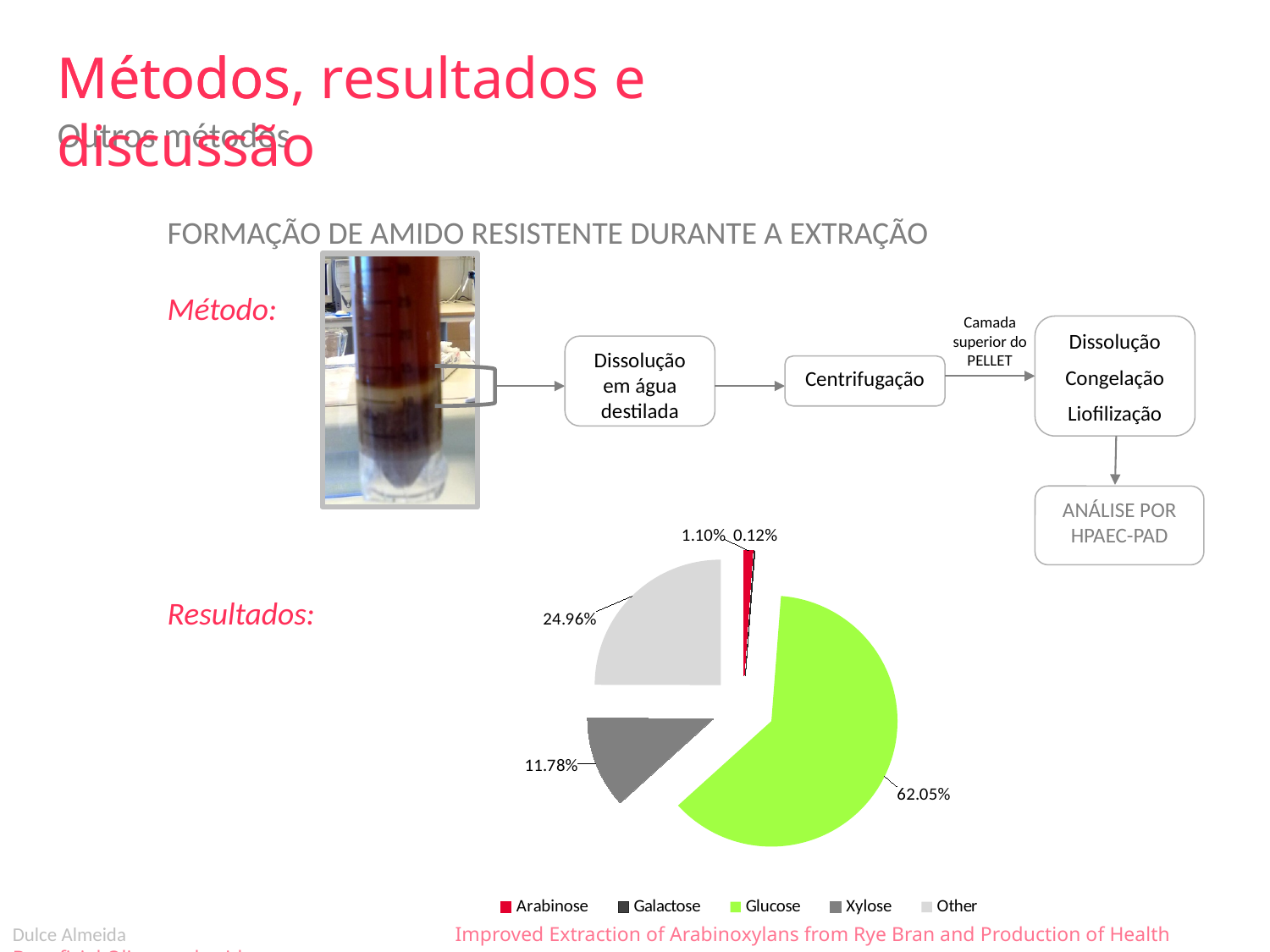
Which category has the smallest slice of the pie? Galactose Which is larger, the Xylose share or the Other share? Other What type of chart is shown on the slide? pie chart What share of the pie does Xylose represent? 11.78% What share of the pie does Galactose represent? 0.12% What is the difference between the Glucose share and the Other share? 37.09% What colour is the Glucose slice in the pie chart? green What share of the pie does Arabinose represent? 1.10% How many categories does the legend of the pie chart list? 5 Which category has the largest slice of the pie? Glucose What share of the pie does Other represent? 24.96% What share of the pie does Glucose represent? 62.05%